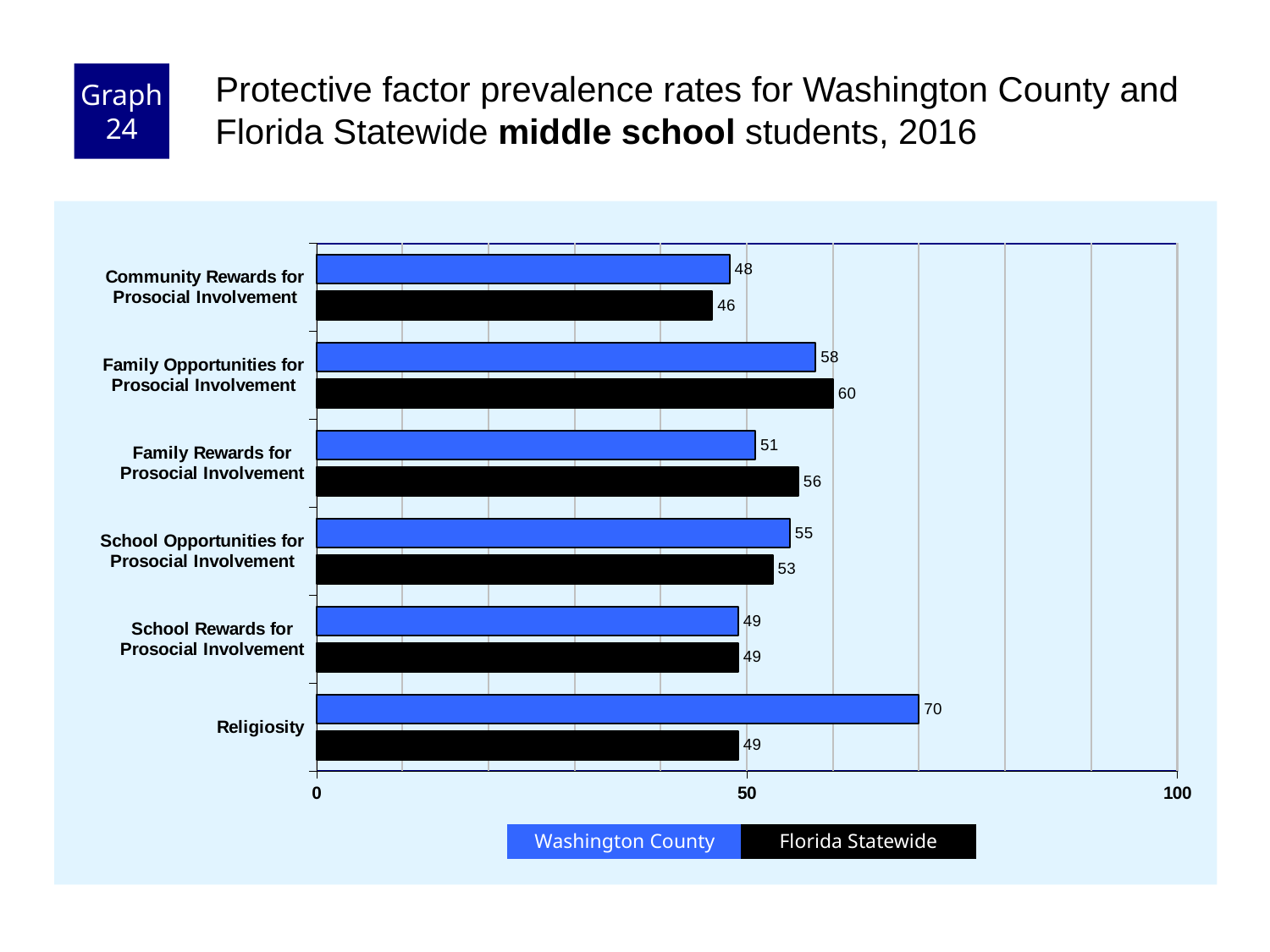
Which protective factor has the highest Washington County value? Religiosity What is the difference between the Washington County and Florida Statewide values for Religiosity? 21 What is the Washington County value for Community Rewards for Prosocial Involvement? 48 Is the Washington County value for Religiosity greater or less than 50? greater Which protective factor has the lowest Florida Statewide value? Community Rewards for Prosocial Involvement Which colour represents Florida Statewide in the chart? Black What is the Washington County value for Religiosity? 70 How many series does the legend list? 2 For Family Rewards for Prosocial Involvement, which is larger: the Washington County value or the Florida Statewide value? Florida Statewide What is the Florida Statewide value for Family Opportunities for Prosocial Involvement? 60 How many protective factors are shown on the chart? 6 What kind of chart is shown on the slide? Bar chart